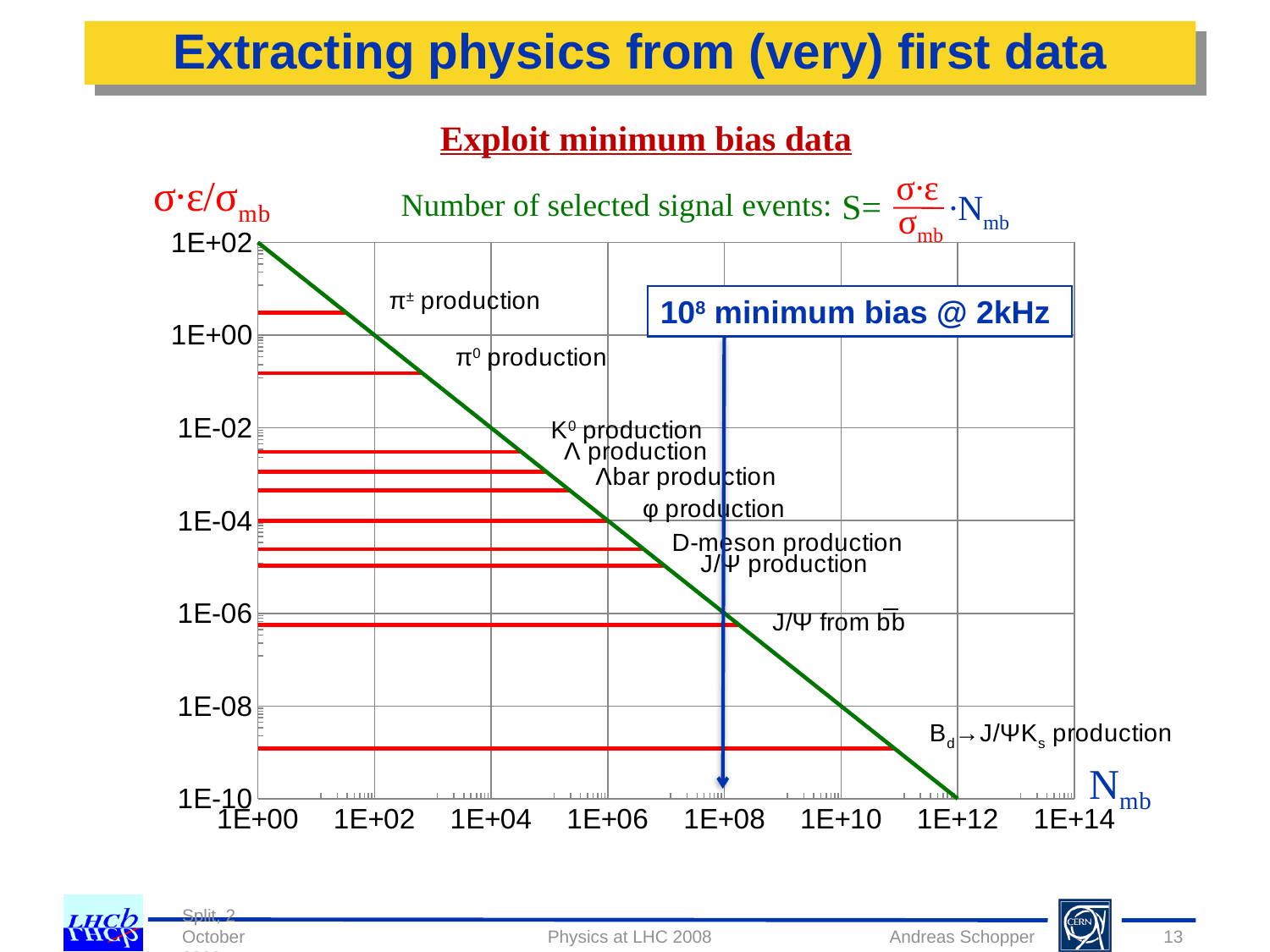
Is the σ·ε/σmb value for π0 production greater or less than 1E-02? greater Is the σ·ε/σmb value for D-meson production greater or less than 1E-04? less Which has the larger σ·ε/σmb value, K0 production or J/Ψ production? K0 production Is the σ·ε/σmb value for Bd→J/ΨKs production greater or less than 1E-08? less Which labelled production process has the lowest σ·ε/σmb value on the chart? Bd→J/ΨKs production At what Nmb value is the vertical blue arrow labelled '10^8 minimum bias @ 2kHz' drawn? 1E+08 What is the label on the x axis of the chart? Nmb Does the green diagonal line rise or fall as Nmb increases along the x axis? fall Which labelled production process has the highest σ·ε/σmb value on the chart? π± production What kind of chart is shown on the slide? line chart How many production processes are labelled with red horizontal lines on the chart? 10